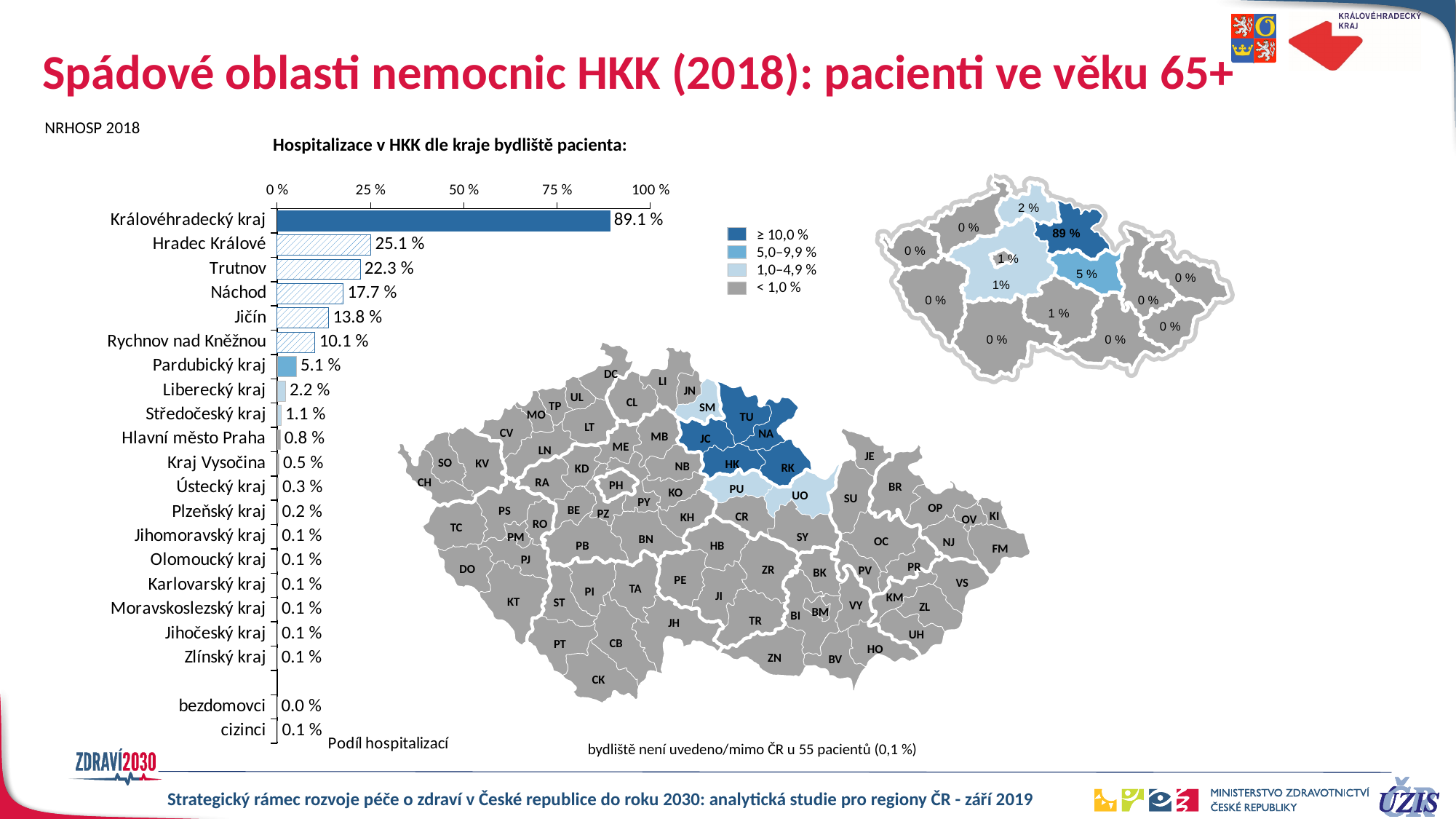
In the bar chart, what is the value for Rychnov nad Kněžnou? 10.1 % What is the maximum value shown on the horizontal axis of the bar chart? 100 % In the bar chart, what is the value for Pardubický kraj? 5.1 % In the bar chart, what is the value for Královéhradecký kraj? 89.1 % Which category has the lowest value in the bar chart? bezdomovci In the bar chart, what is the value for Trutnov? 22.3 % Which category has the highest value in the bar chart? Královéhradecký kraj What type of chart is shown under the title "Hospitalizace v HKK dle kraje bydliště pacienta"? bar chart In the bar chart, what is the difference between the values for Hradec Králové and Trutnov? 2.8 % In the bar chart, which has a larger value, Náchod or Jičín? Náchod In the bar chart, is the value for Královéhradecký kraj greater or less than 75 %? greater How many categories are listed in the bar chart? 21